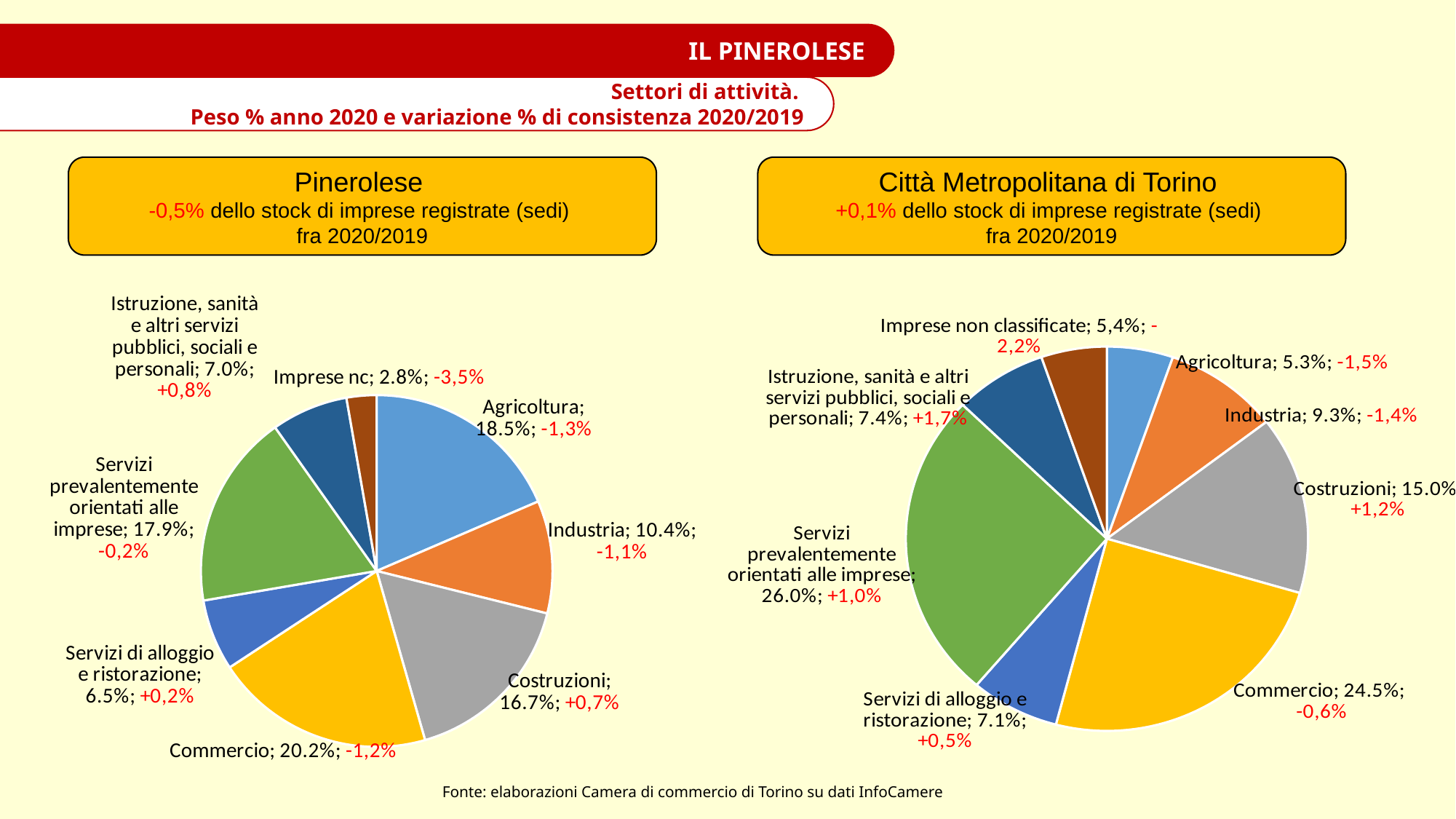
What type of chart is used for Città Metropolitana di Torino? Pie chart In the Città Metropolitana di Torino pie chart, what is the variation % shown for Costruzioni? +1,2% In the Pinerolese pie chart, what is the difference in share between Agricoltura and Industria? 8.1% In the Città Metropolitana di Torino pie chart, what share does Servizi prevalentemente orientati alle imprese have? 26.0% In the Pinerolese pie chart, which sector has the largest share? Commercio In the Pinerolese pie chart, what share does Commercio have? 20.2% In the Città Metropolitana di Torino pie chart, which sector has the largest share? Servizi prevalentemente orientati alle imprese In the Città Metropolitana di Torino pie chart, which sector has the smallest share? Agricoltura In the Pinerolese pie chart, what is the variation % shown for Imprese nc? -3,5% How many slices does the Pinerolese pie chart have? 8 In the Città Metropolitana di Torino pie chart, which has a larger share, Commercio or Costruzioni? Commercio In the Pinerolese pie chart, which sector has the smallest share? Imprese nc